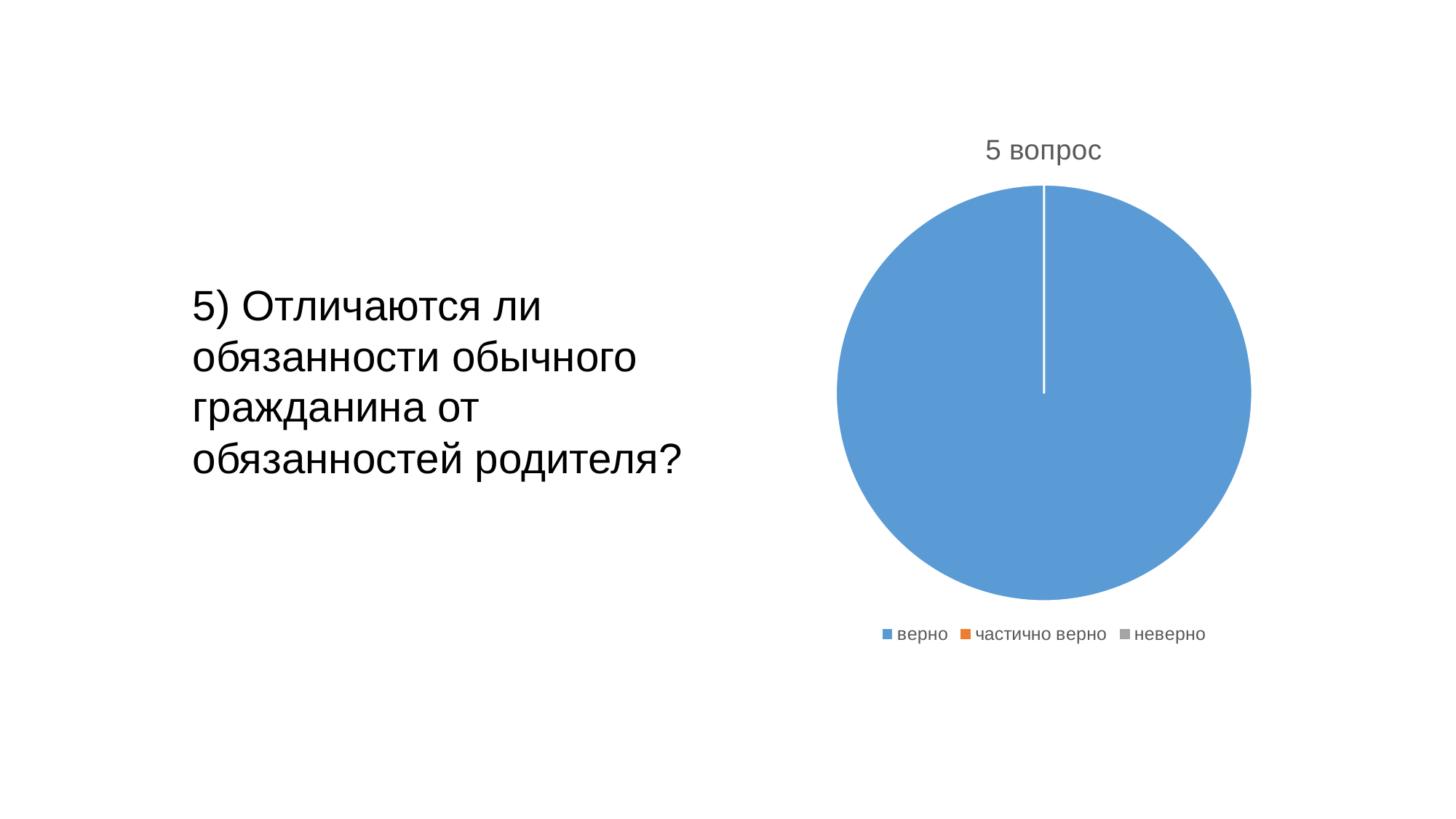
Which is larger in the pie: верно or частично верно? верно What is the title of the chart? 5 вопрос What kind of chart is shown on the slide? pie chart Which category does the blue slice of the pie represent? верно Which category has the largest slice of the pie? верно How many entries does the chart legend list? 3 Which is larger in the pie: верно or неверно? верно Which category fills the entire pie? верно